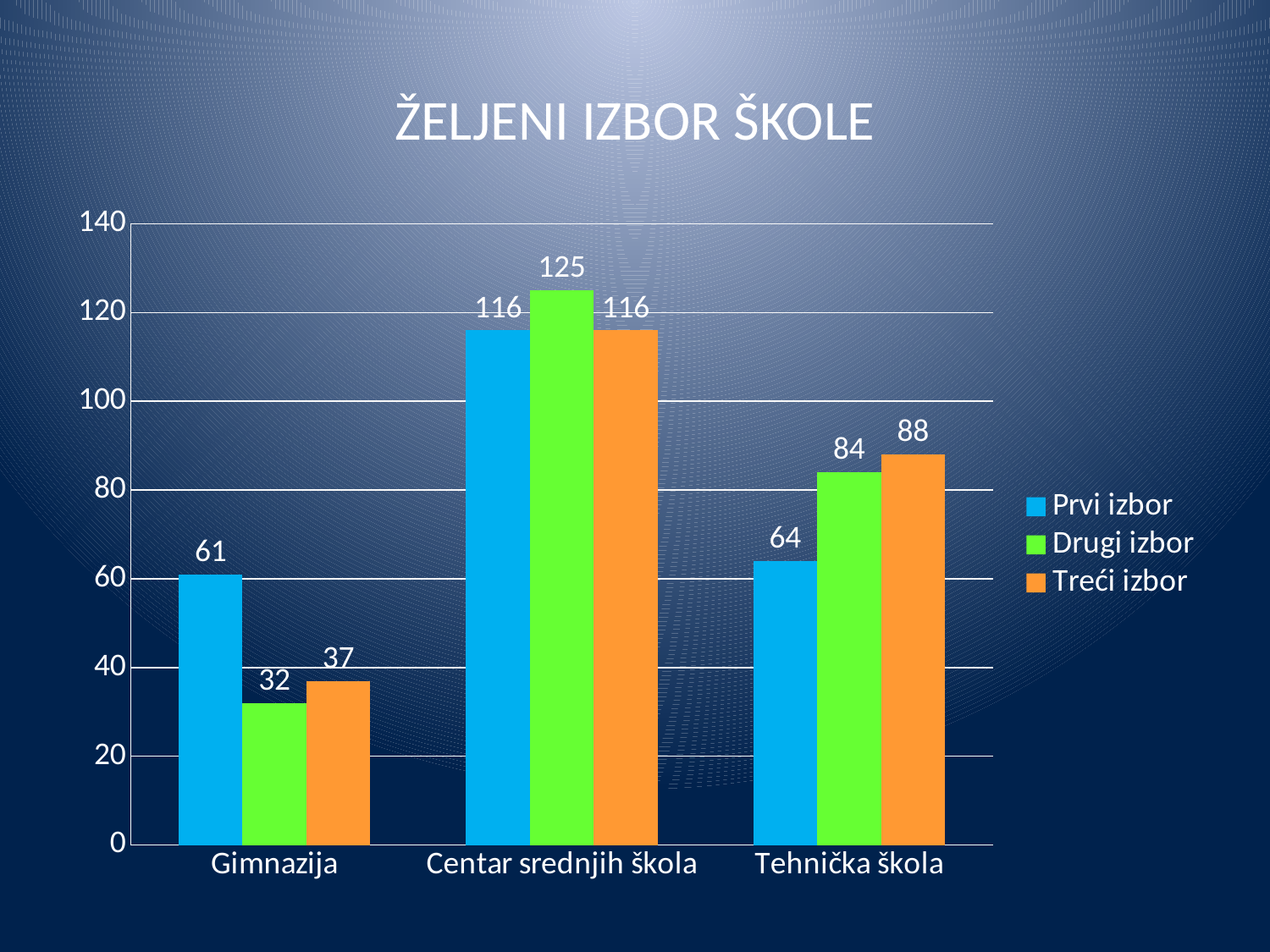
What kind of chart is shown on the slide? bar chart What is the value of Drugi izbor for Centar srednjih škola? 125 What is the value of Treći izbor for Tehnička škola? 88 How many series does the legend list? 3 What is the value of Prvi izbor for Gimnazija? 61 How many categories are shown on the x axis? 3 Is the Treći izbor value for Gimnazija greater or less than 40? less Which is larger for Tehnička škola: Prvi izbor or Drugi izbor? Drugi izbor What is the difference between the Drugi izbor and Prvi izbor values for Centar srednjih škola? 9 Which category has the lowest Drugi izbor value? Gimnazija Which category has the highest Prvi izbor value? Centar srednjih škola What is the title of the chart? ŽELJENI IZBOR ŠKOLE